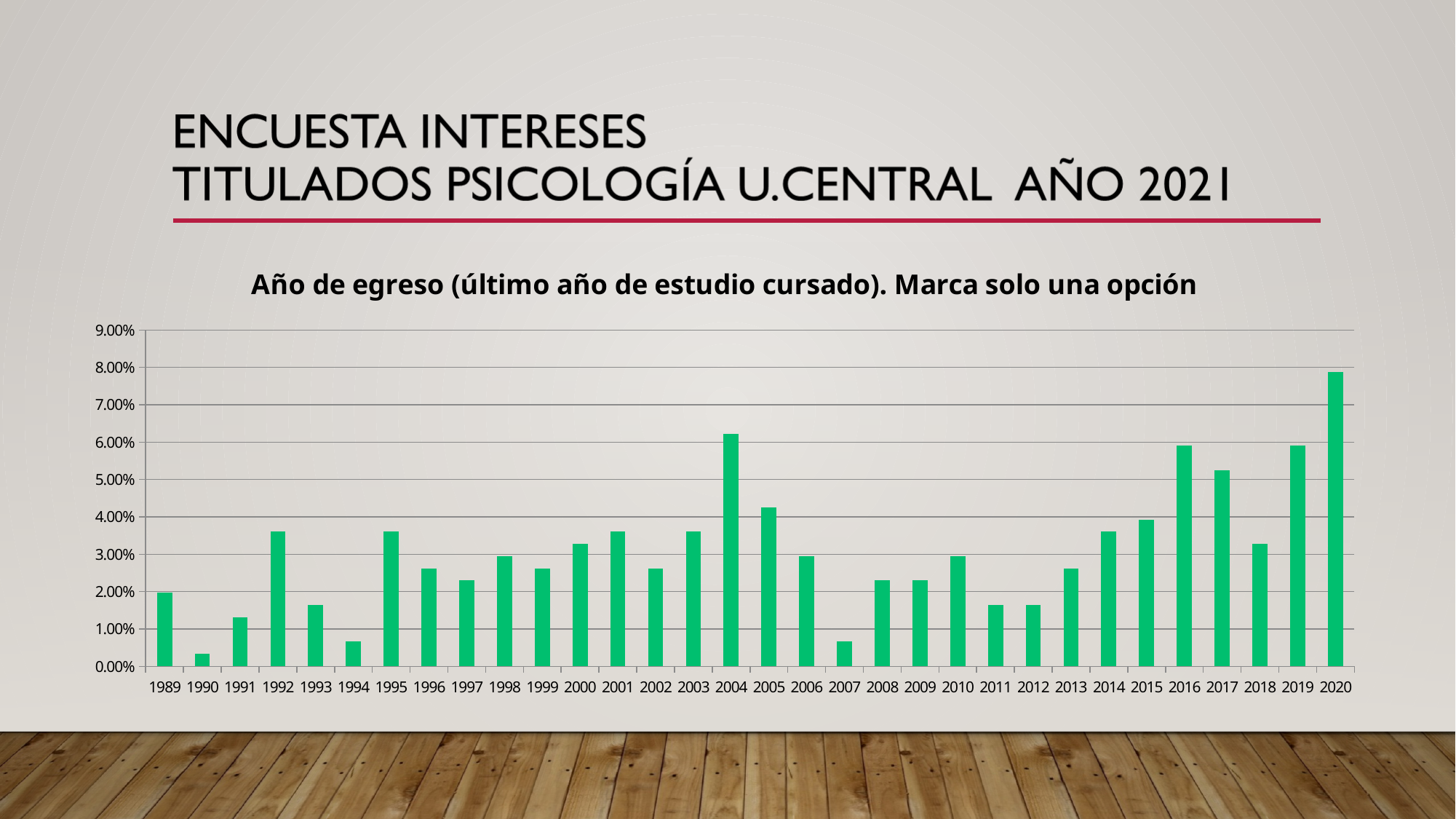
Is the value for 1990 greater or less than 1.00%? less Which year has the larger value, 2016 or 2017? 2016 What kind of chart is shown on the slide? Bar chart What is the title of the chart? Año de egreso (último año de estudio cursado). Marca solo una opción Which year has the larger value, 2004 or 2005? 2004 Is the value for 2016 greater or less than 5.00%? greater Is the value for 2011 greater or less than 2.00%? less Do the values rise or fall from 2012 to 2016? rise Which year has the highest value in the chart? 2020 Which year has the lowest value in the chart? 1990 How many years are shown on the x axis of the chart? 32